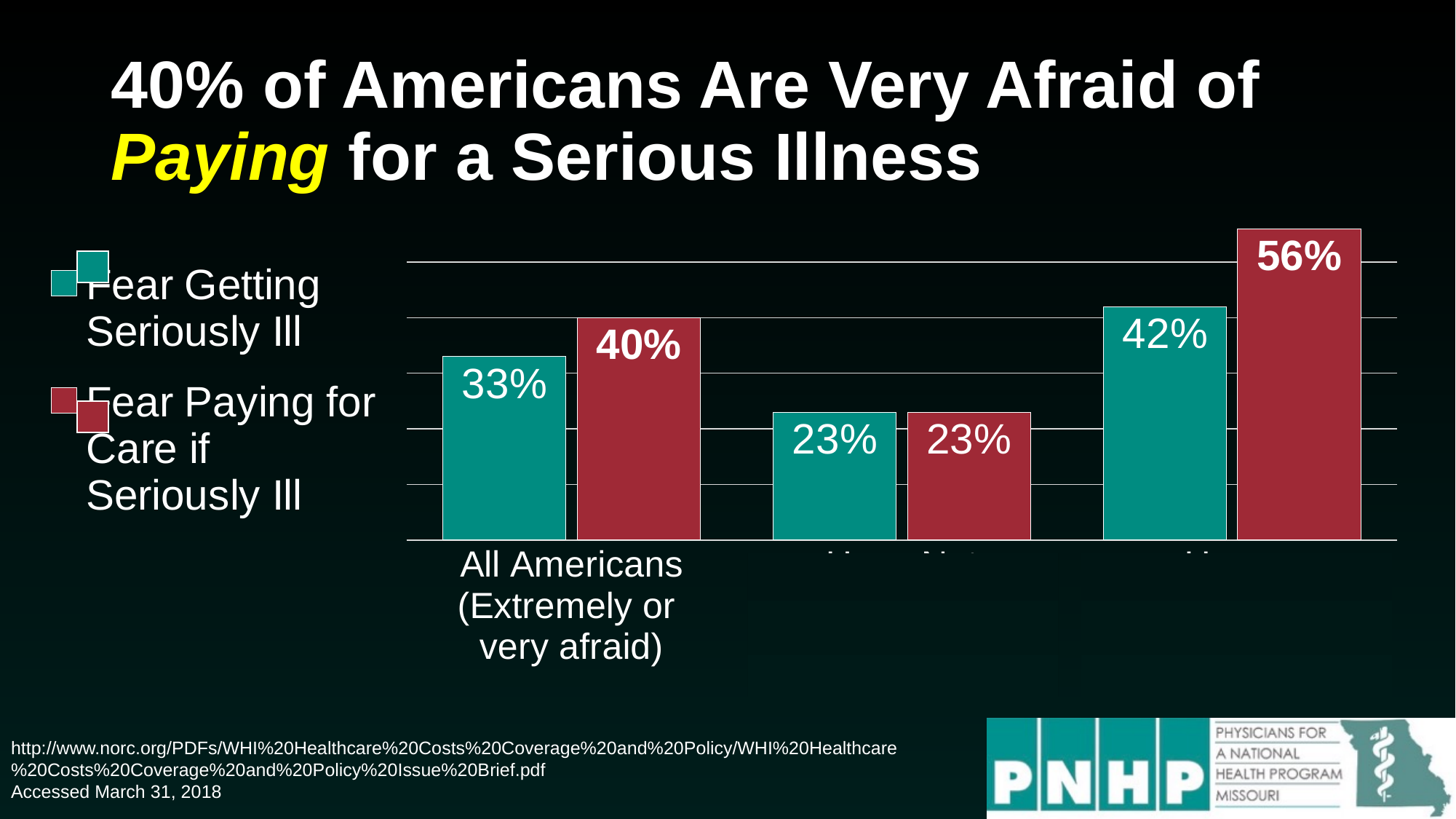
What is the value for Fear Paying for Care if Seriously Ill among All Americans (Extremely or very afraid)? 40% What colour represents the Fear Getting Seriously Ill series? Teal What is the value of the Fear Getting Seriously Ill bar in the rightmost group? 42% For All Americans (Extremely or very afraid), what is the difference between Fear Paying for Care if Seriously Ill and Fear Getting Seriously Ill? 7 percentage points What kind of chart is shown on the slide? Bar chart What is the value of the Fear Paying for Care if Seriously Ill bar in the rightmost group? 56% How many series does the legend list? 2 How many groups of bars are plotted in the chart? 3 Which series contains the highest value in the chart? Fear Paying for Care if Seriously Ill What is the value for Fear Getting Seriously Ill among All Americans (Extremely or very afraid)? 33% For All Americans (Extremely or very afraid), which is larger: Fear Getting Seriously Ill or Fear Paying for Care if Seriously Ill? Fear Paying for Care if Seriously Ill What is the highest value shown in the chart? 56%